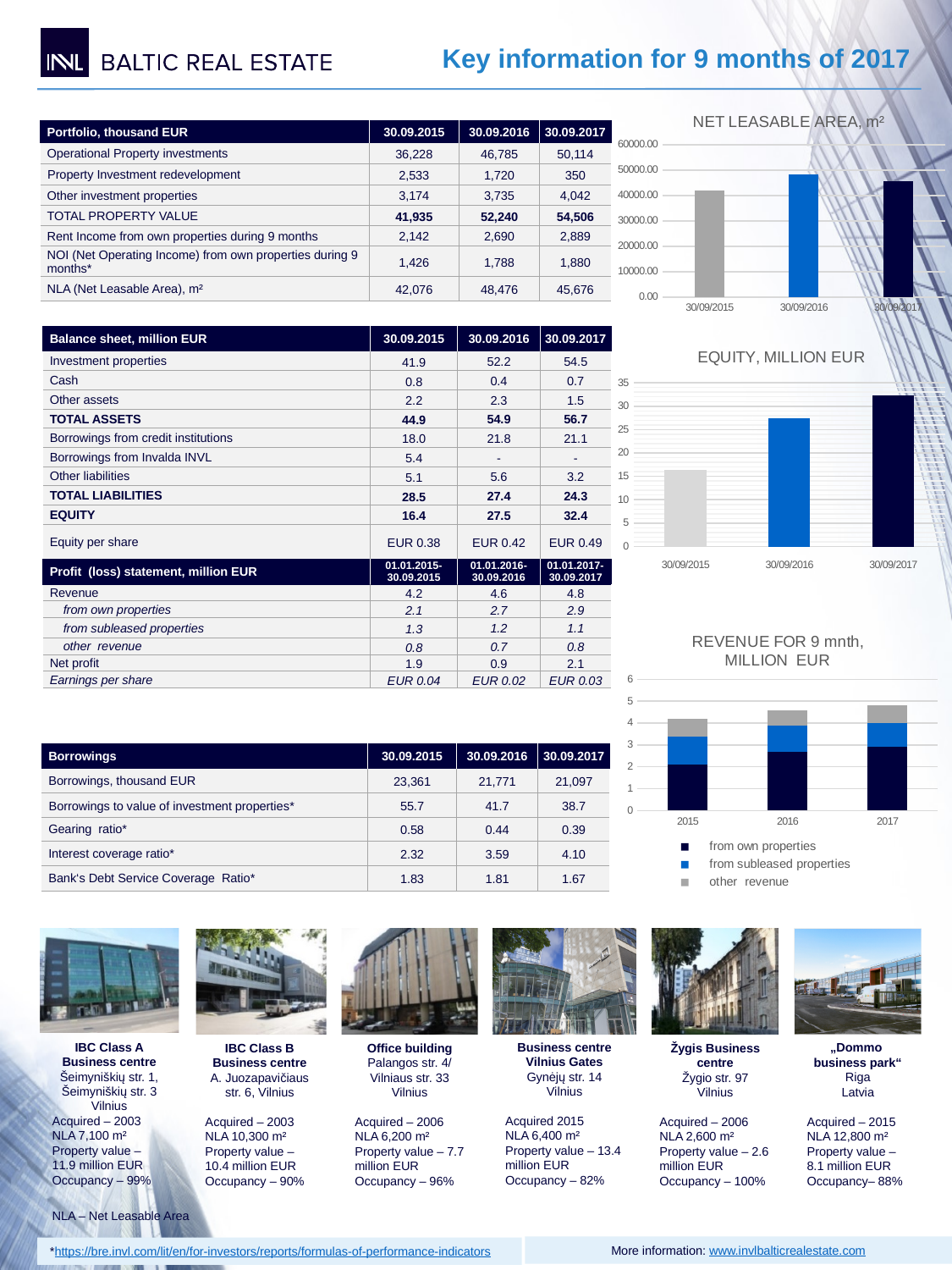
In the EQUITY, MILLION EUR chart, is the value for 30/09/2017 greater or less than 30? greater In the NET LEASABLE AREA, m² chart, how many bars are plotted? 3 What type of chart is the NET LEASABLE AREA, m² chart? bar chart In the NET LEASABLE AREA, m² chart, which date has the lowest bar? 30/09/2015 In the NET LEASABLE AREA, m² chart, is the value for 30/09/2017 greater or less than 50000.00? less In the EQUITY, MILLION EUR chart, is the value for 30/09/2015 greater or less than 20? less In the EQUITY, MILLION EUR chart, which is larger, the value for 30/09/2016 or 30/09/2015? 30/09/2016 In the EQUITY, MILLION EUR chart, which date has the highest equity? 30/09/2017 How many series does the legend of the REVENUE FOR 9 mnth, MILLION EUR chart list? 3 In the REVENUE FOR 9 mnth, MILLION EUR chart, which series is shown in the lightest grey colour? other revenue In the NET LEASABLE AREA, m² chart, which date has the highest bar? 30/09/2016 In the EQUITY, MILLION EUR chart, do the values rise or fall from 30/09/2015 to 30/09/2017? rise